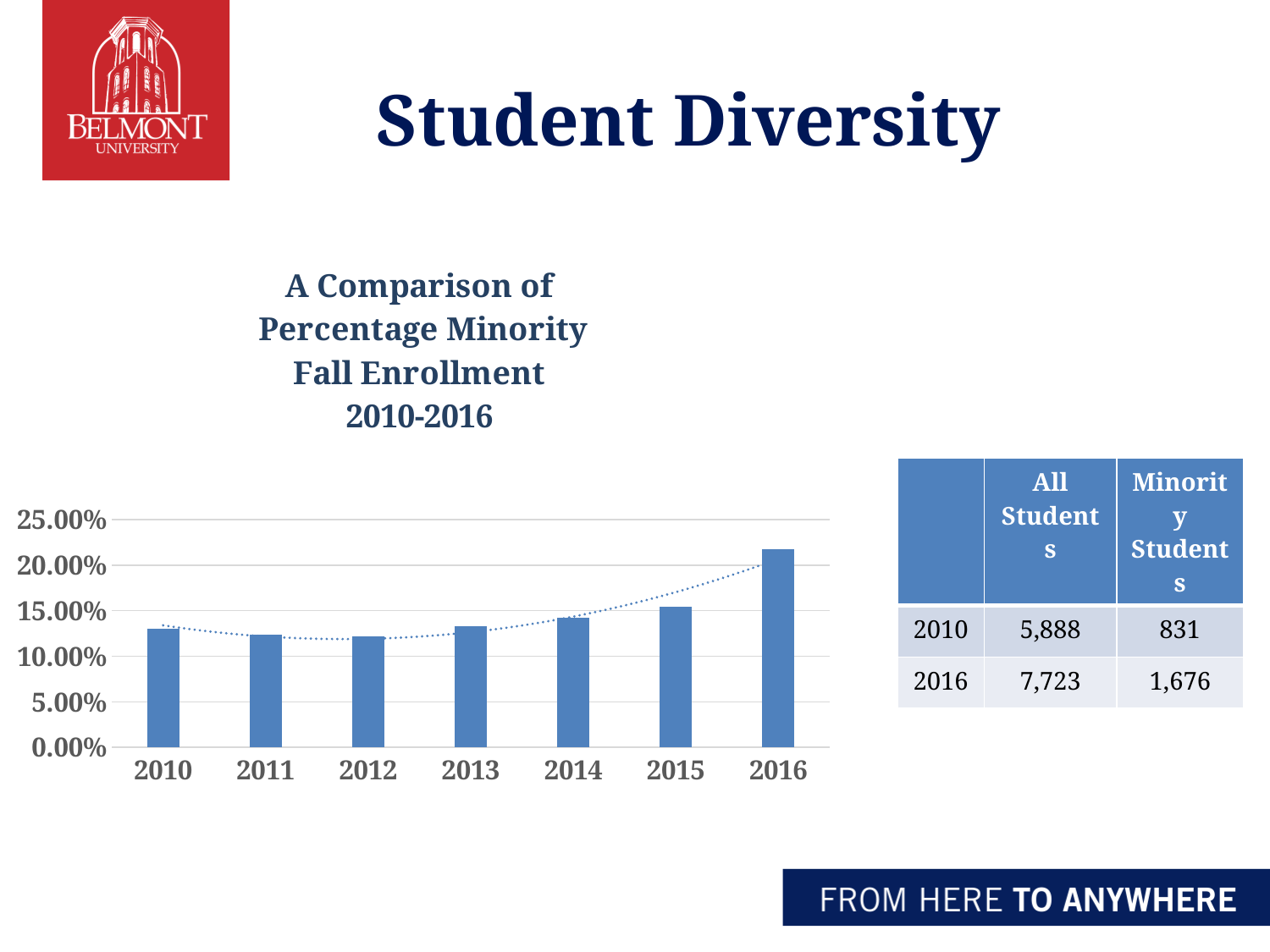
What is the title of the chart? A Comparison of Percentage Minority Fall Enrollment 2010-2016 Is the value for 2016 greater or less than 20.00%? greater How many years are shown on the x axis of the chart? 7 Do the values rise or fall from 2013 to 2016? rise Is the value for 2014 greater or less than 15.00%? less Is the value for 2015 greater or less than 20.00%? less What kind of chart is shown on the slide? bar chart Which year has the larger value, 2015 or 2012? 2015 Which year has the larger value, 2016 or 2010? 2016 Which year has the highest percentage minority fall enrollment in the chart? 2016